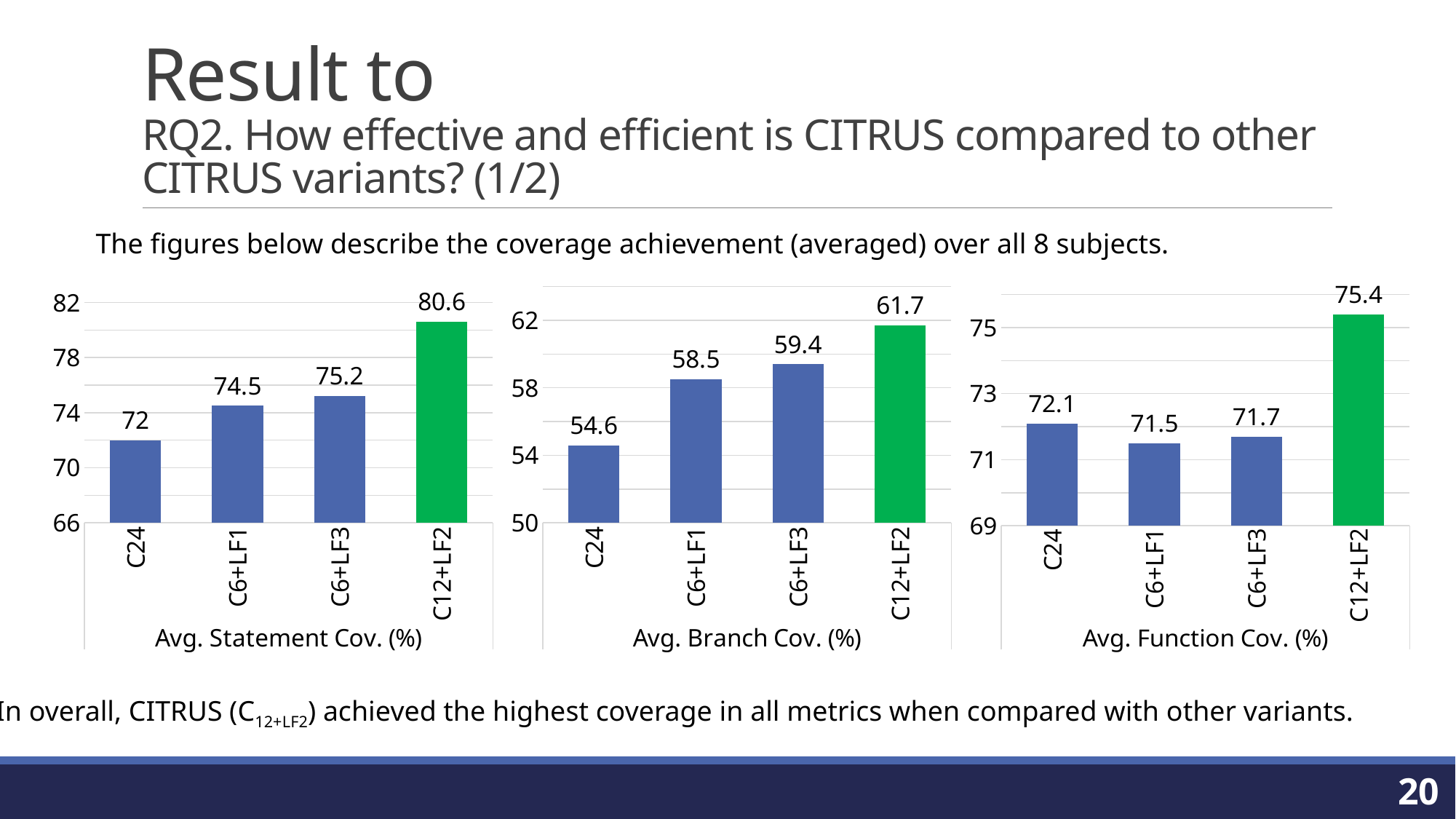
In the Avg. Branch Cov. (%) chart, what is the difference between C6+LF3 and C6+LF1? 0.9 In the Avg. Statement Cov. (%) chart, which category has the lowest value? C24 How many categories are shown in the Avg. Branch Cov. (%) chart? 4 In the Avg. Function Cov. (%) chart, what is the value for C6+LF3? 71.7 In the Avg. Function Cov. (%) chart, which category has the lowest value? C6+LF1 In the Avg. Branch Cov. (%) chart, what colour is the C12+LF2 bar? green In the Avg. Branch Cov. (%) chart, which category has the highest value? C12+LF2 In the Avg. Statement Cov. (%) chart, what is the value for C12+LF2? 80.6 In the Avg. Statement Cov. (%) chart, what is the difference between C12+LF2 and C24? 8.6 What kind of chart is the Avg. Statement Cov. (%) chart? bar chart In the Avg. Function Cov. (%) chart, which is larger, C24 or C6+LF3? C24 In the Avg. Branch Cov. (%) chart, what is the value for C6+LF1? 58.5